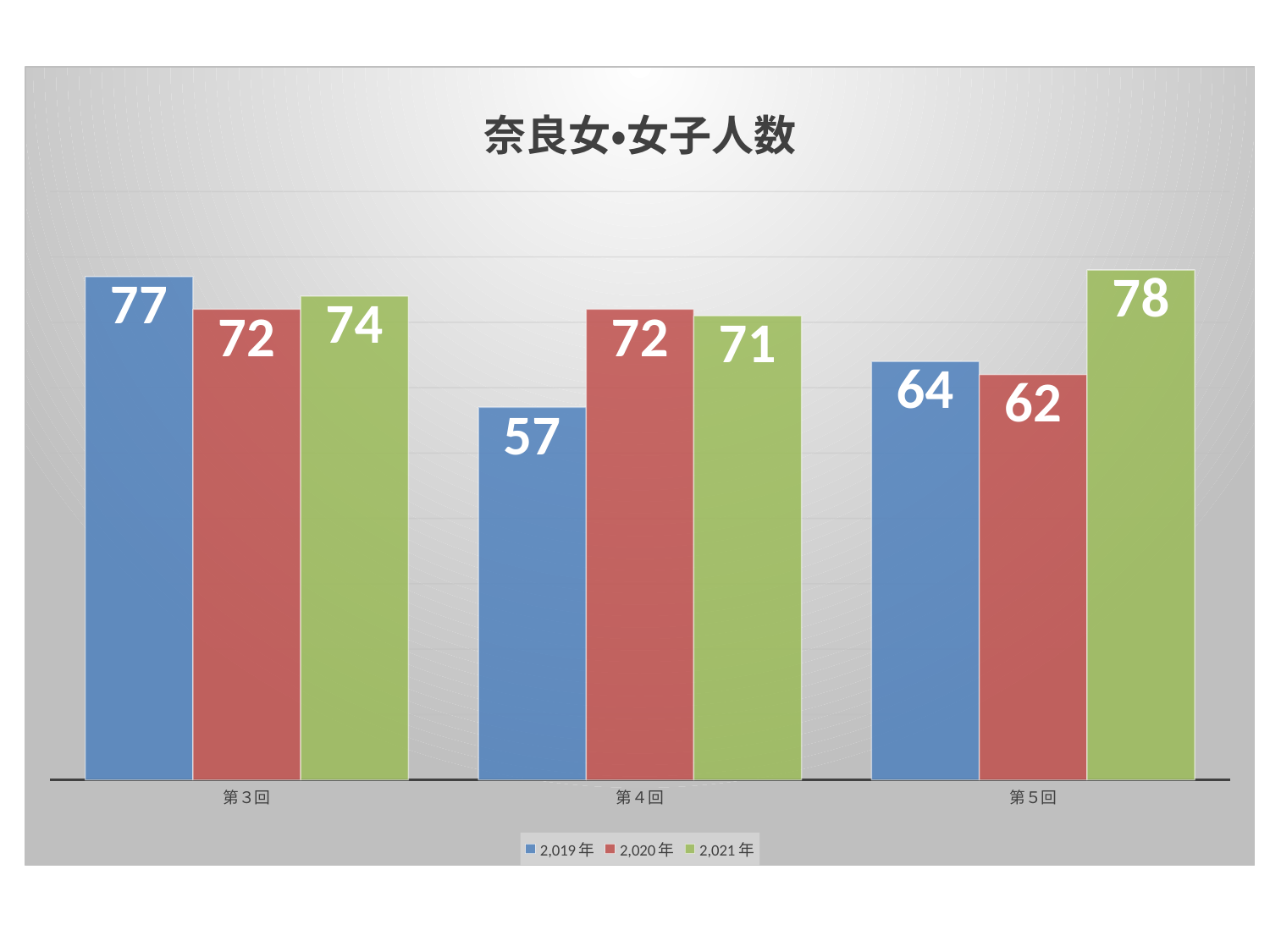
What is the title of the chart? 奈良女•女子人数 Which category has the lowest value for 2,019 年? 第4回 What is the value for 2,020 年 at 第4回? 72 How many categories are shown on the x axis? 3 What is the value for 2,021 年 at 第5回? 78 What is the value for 2,019 年 at 第4回? 57 What kind of chart is shown? bar chart Which category has the highest value for 2,021 年? 第5回 Which is larger at 第4回: the 2,020 年 value or the 2,019 年 value? 2,020 年 What is the value for 2,019 年 at 第3回? 77 How many series does the legend list? 3 What is the difference between the 2,021 年 and 2,019 年 values at 第5回? 14